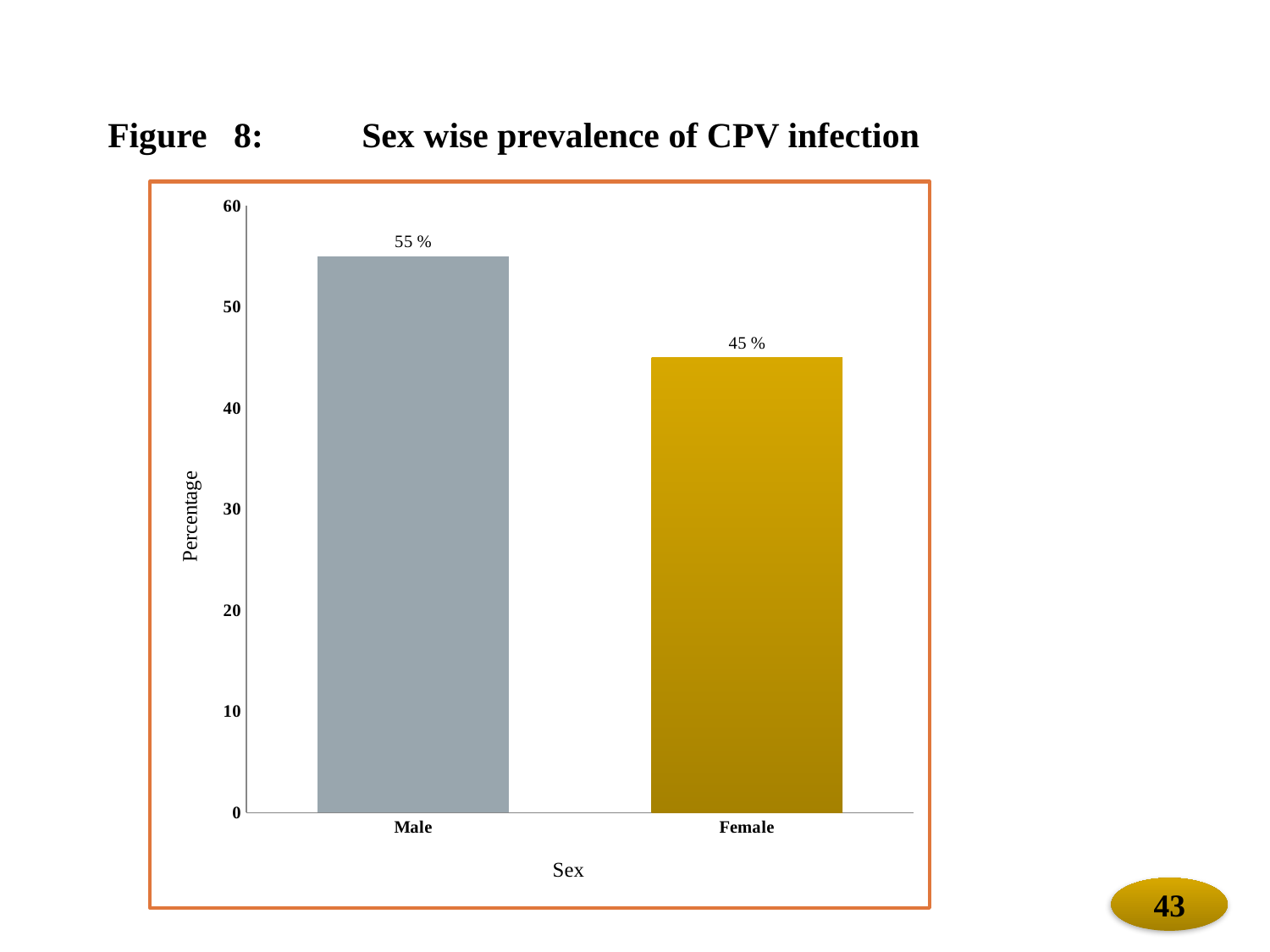
Is the value for Male greater or less than 50? greater What is the label of the y axis? Percentage What is the title of the figure? Sex wise prevalence of CPV infection What is the total of the Male and Female percentages? 100 % What is the percentage value for Female? 45 % What is the difference in percentage between Male and Female? 10 % Is the value for Female greater or less than 50? less Which sex has the lower prevalence of CPV infection? Female Which sex has the higher prevalence of CPV infection? Male How many categories are shown on the x axis? 2 What is the percentage value for Male? 55 % What kind of chart is shown on the slide? bar chart